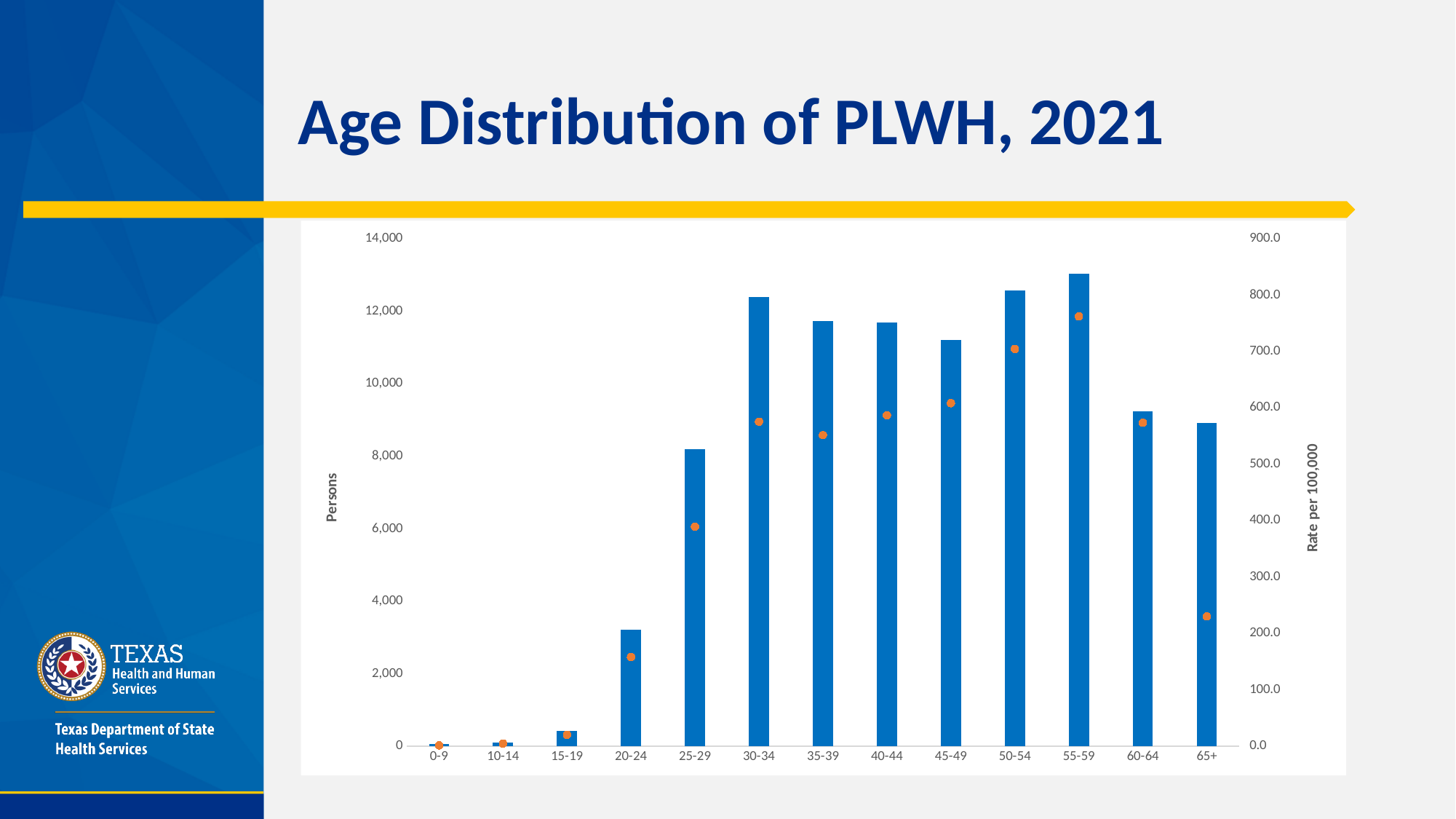
Is the rate per 100,000 for the 65+ age group greater or less than 300.0? less Is the number of persons for the 20-24 age group greater or less than 4,000? less Is the number of persons for the 30-34 age group greater or less than 12,000? greater Which age group has the tallest bar (most persons)? 55-59 How many age groups are shown on the x axis? 13 Which age group has more persons, 20-24 or 25-29? 25-29 Which age group has the highest rate per 100,000 (orange dot)? 55-59 Do the bars rise or fall from the 0-9 age group to the 30-34 age group? rise Which age group has more persons, 30-34 or 45-49? 30-34 Which age group has the shortest bar (fewest persons)? 0-9